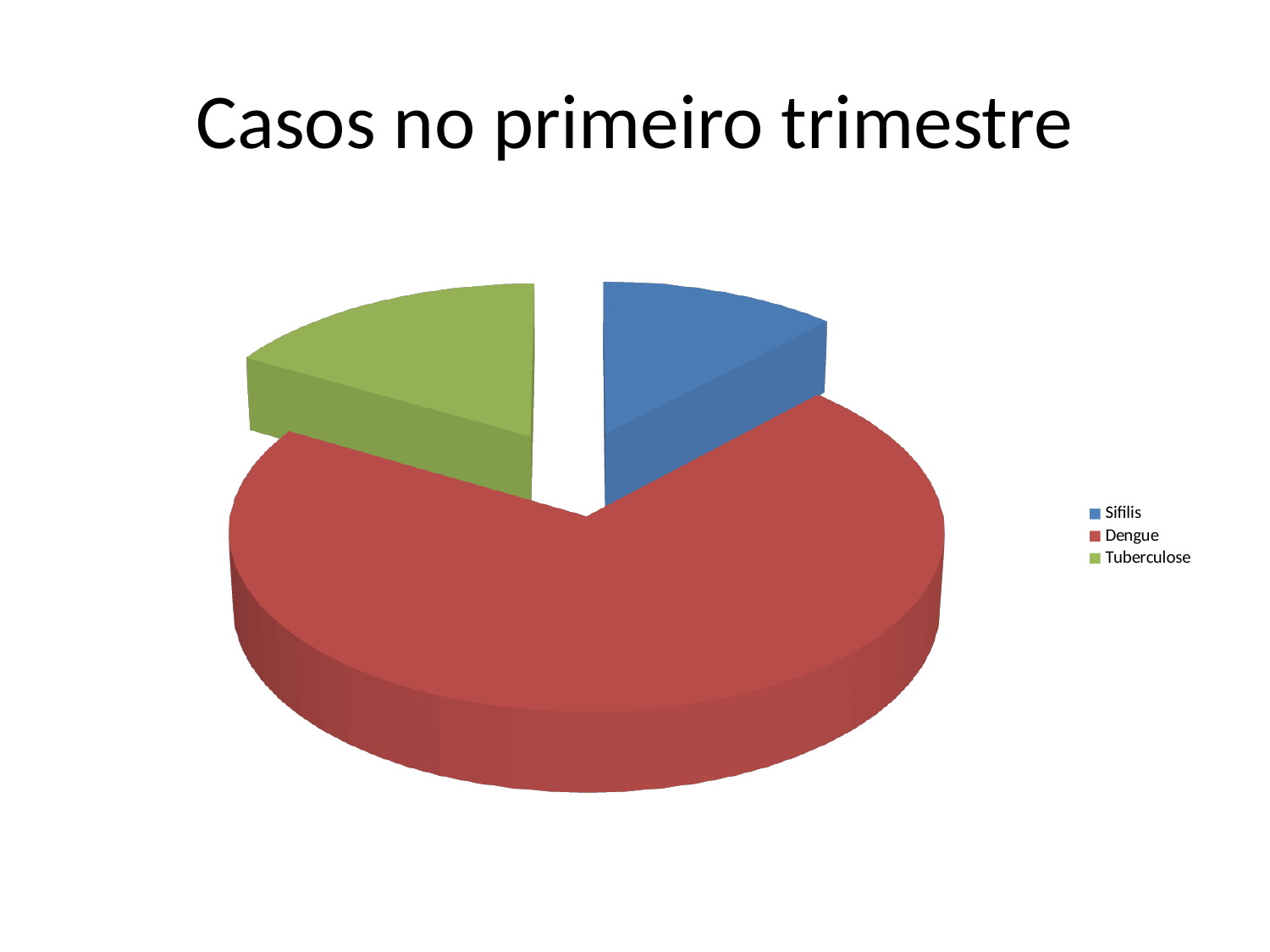
Which slice is larger, Dengue or Tuberculose? Dengue What colour is the Dengue slice? red What kind of chart is shown on the slide? pie chart What is the title of the chart? Casos no primeiro trimestre Which category has the largest slice of the pie? Dengue Which slice is larger, Dengue or Sifilis? Dengue How many entries does the legend list? 3 Which category is shown in blue? Sifilis How many slices does the pie chart have? 3